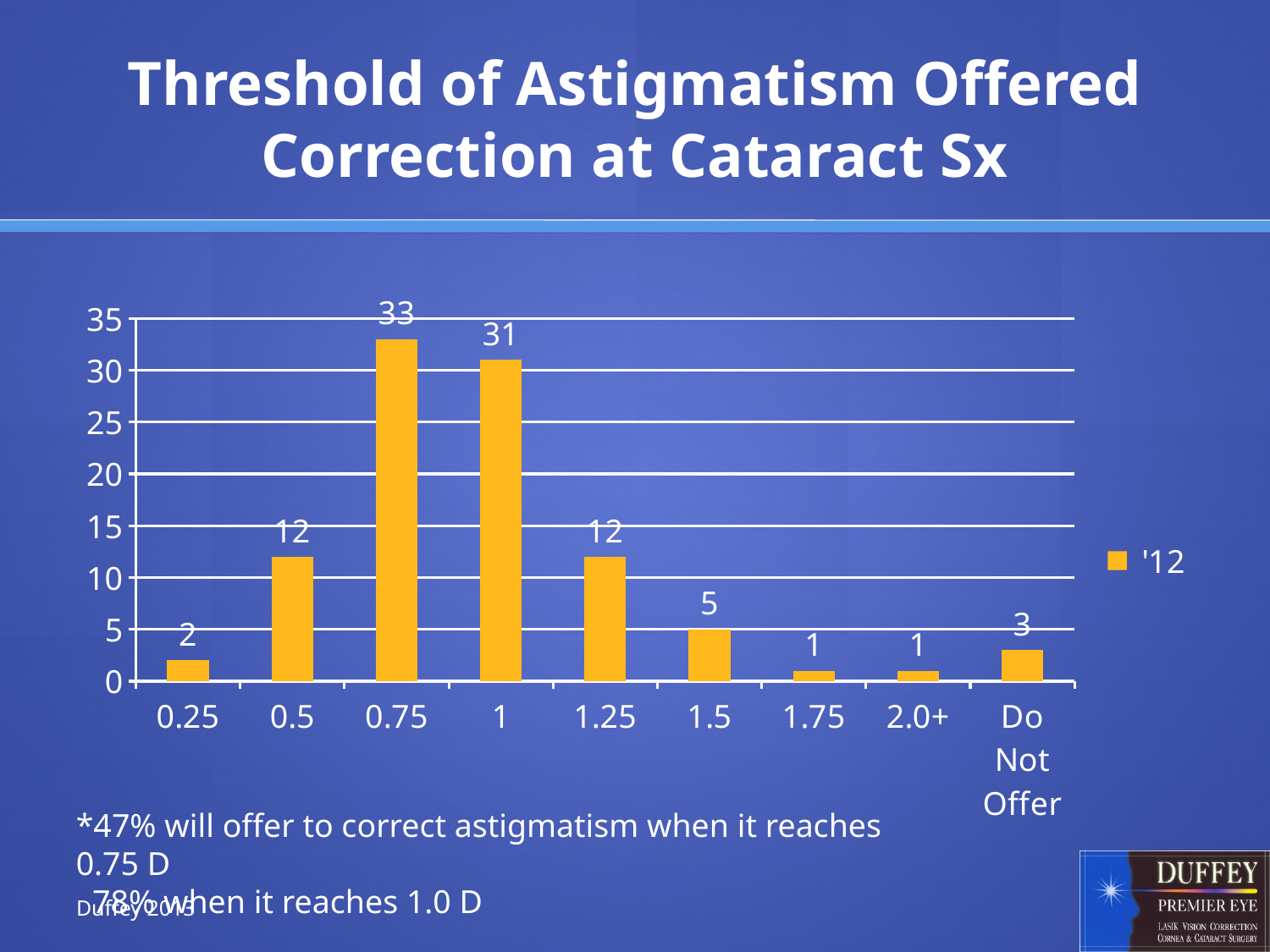
Which category has the highest value? 0.75 Is the value for 1 greater or less than 30? greater What is the value for the 1.25 category? 12 What is the name of the series in the legend? '12 What kind of chart is shown? bar chart How many series does the legend list? 1 Which is larger, the value for 0.5 or the value for 1.5? 0.5 What is the title of the chart? Threshold of Astigmatism Offered Correction at Cataract Sx What is the difference between the values for 0.75 and 1? 2 What is the value for the 0.75 category? 33 How many categories are shown on the x axis? 9 What is the value for the Do Not Offer category? 3